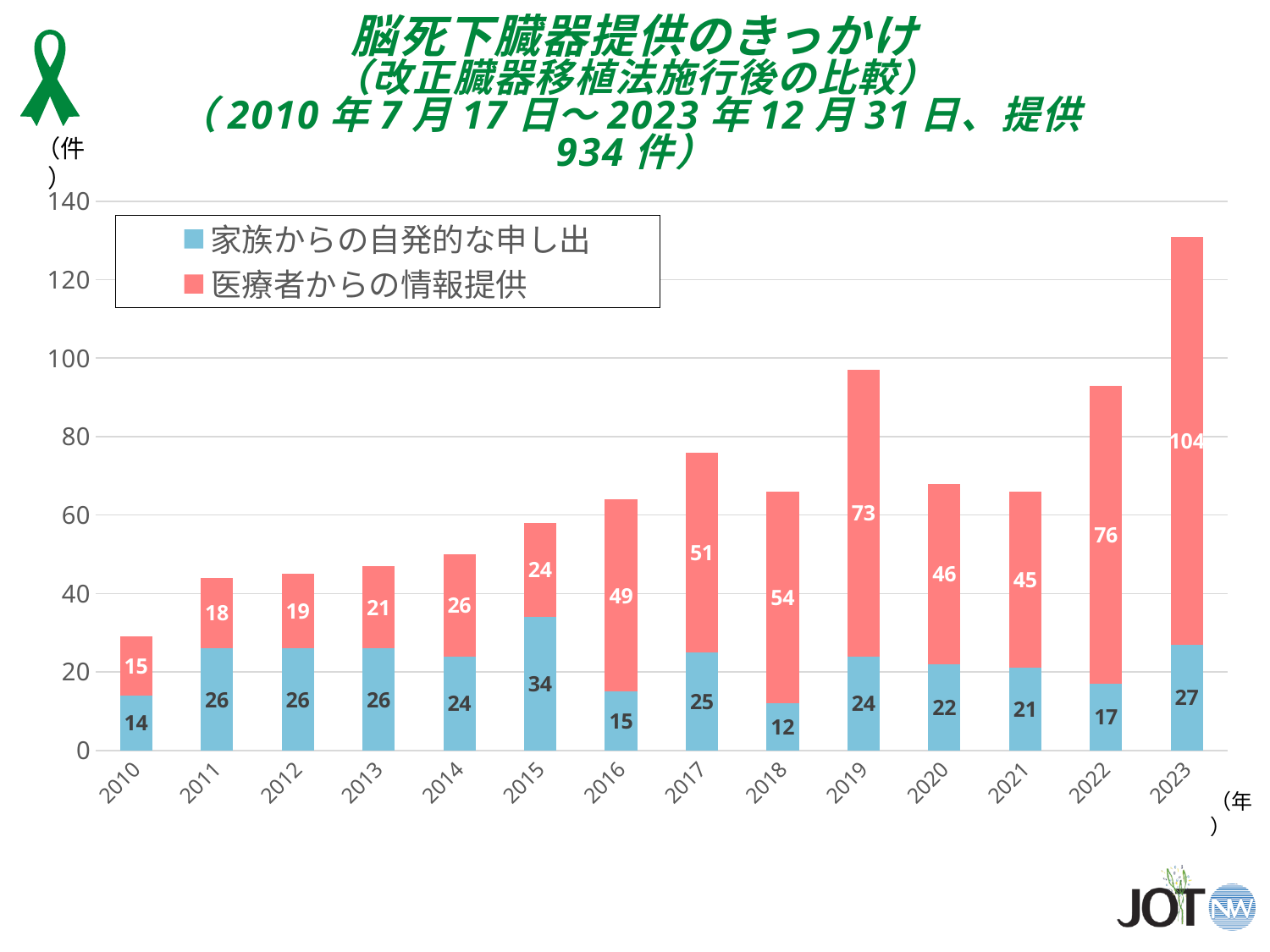
What is the value for 家族からの自発的な申し出 in 2015? 34 How many series does the legend list? 2 Is the total of the stacked bar for 2023 greater or less than 120? greater Which year has the highest value for 医療者からの情報提供? 2023 Which year has the lowest value for 家族からの自発的な申し出? 2018 What is the difference between 医療者からの情報提供 in 2022 and in 2021? 31 Which is larger in 2016: 家族からの自発的な申し出 or 医療者からの情報提供? 医療者からの情報提供 Which colour represents 家族からの自発的な申し出 in the legend? Blue What kind of chart is shown on the slide? Stacked bar chart What is the total of the stacked bar for 2019? 97 How many years are shown on the x axis? 14 What is the value for 医療者からの情報提供 in 2023? 104